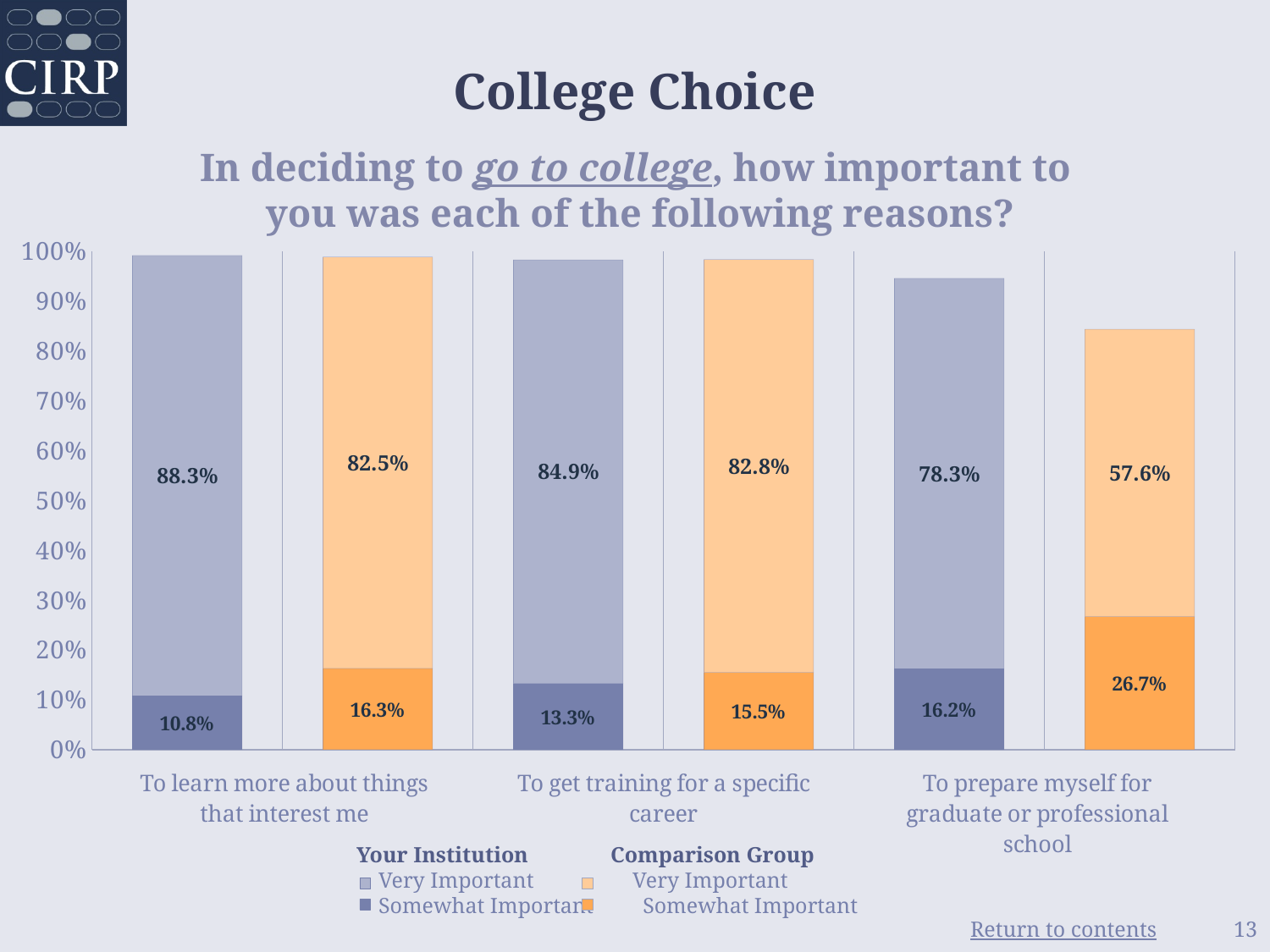
What is the difference between the Your Institution and Comparison Group Very Important percentages for "To prepare myself for graduate or professional school"? 20.7% How many reasons (categories) are shown on the x axis of the chart? 3 Which reason has the highest Very Important percentage for Your Institution? To learn more about things that interest me How many series does the chart legend list? 4 What is the total of the stacked Your Institution bar for "To learn more about things that interest me"? 99.1% What type of chart is shown on the slide? Stacked bar chart What is the total of the stacked Comparison Group bar for "To prepare myself for graduate or professional school"? 84.3% For "To get training for a specific career", which is larger: the Very Important percentage for Your Institution or for the Comparison Group? Your Institution What percentage of Your Institution students rated "To get training for a specific career" as Somewhat Important? 13.3% Which reason has the lowest Very Important percentage for the Comparison Group? To prepare myself for graduate or professional school What percentage of Your Institution students rated "To learn more about things that interest me" as Very Important? 88.3% What percentage of the Comparison Group rated "To prepare myself for graduate or professional school" as Somewhat Important? 26.7%